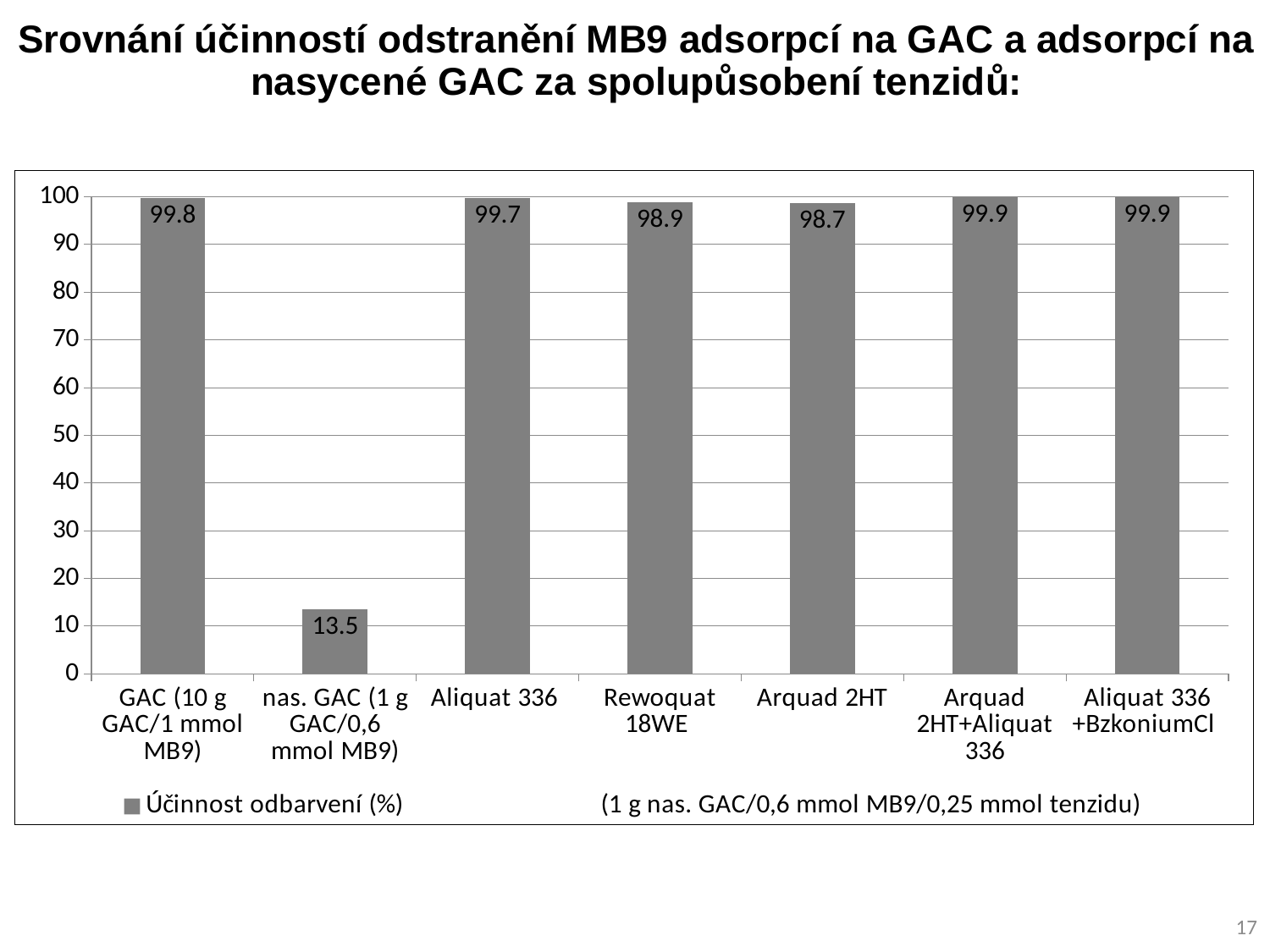
What is the value for Arquad 2HT? 98.7 What kind of chart is shown on the slide? bar chart What is the value for Rewoquat 18WE? 98.9 Which is larger, the value for Aliquat 336 or the value for Arquad 2HT? Aliquat 336 What is the first legend entry of the chart? Účinnost odbarvení (%) (1 g nas. GAC/0,6 mmol MB9/0,25 mmol tenzidu) What is the value for nas. GAC (1 g GAC/0,6 mmol MB9)? 13.5 How many categories are shown on the x axis? 7 Is the value for nas. GAC (1 g GAC/0,6 mmol MB9) greater or less than 20? less What is the value for Aliquat 336? 99.7 Which category has the lowest value? nas. GAC (1 g GAC/0,6 mmol MB9) What is the difference between the values for GAC (10 g GAC/1 mmol MB9) and nas. GAC (1 g GAC/0,6 mmol MB9)? 86.3 What is the difference between the values for Aliquat 336 and Rewoquat 18WE? 0.8